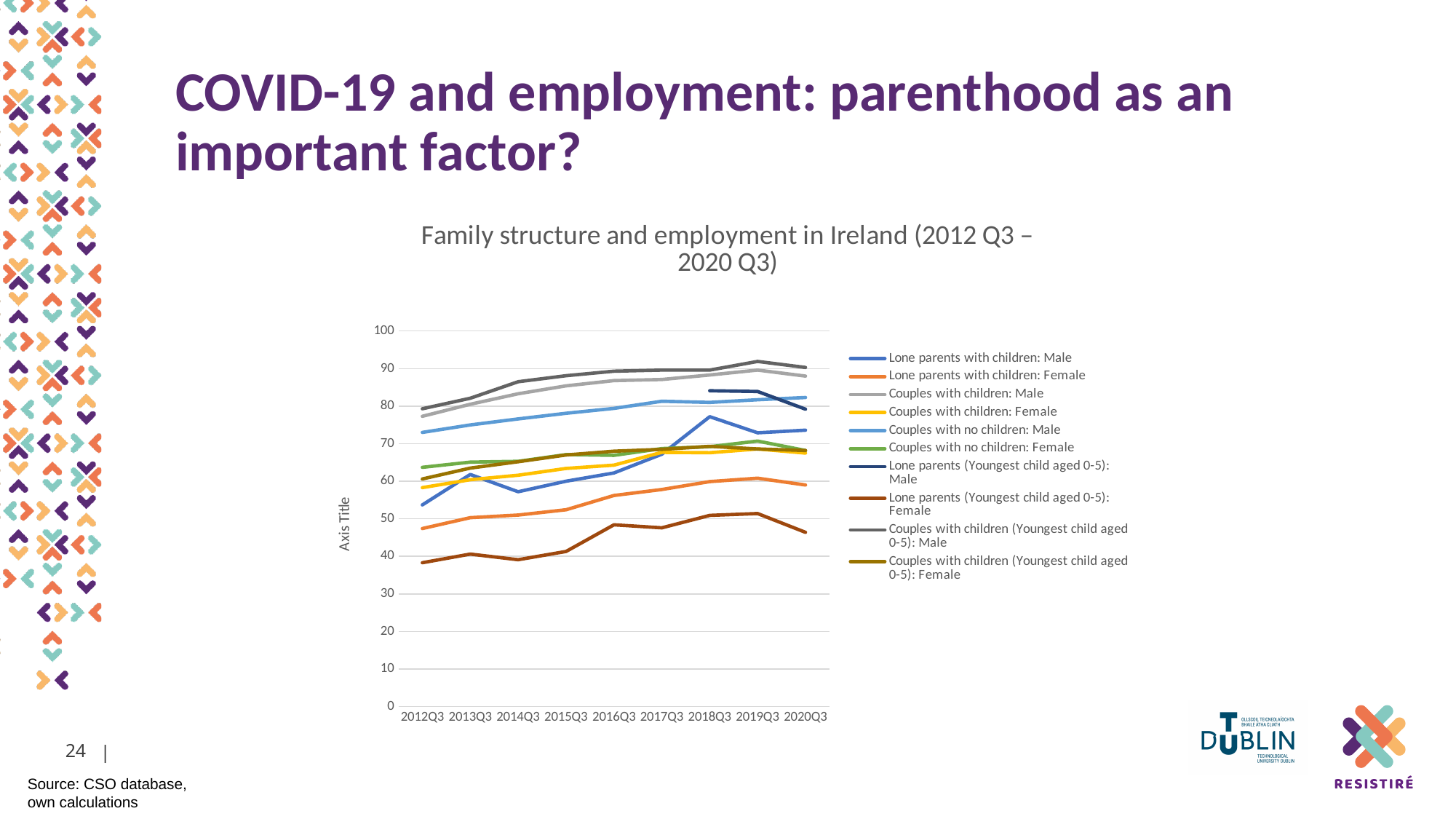
What is the label on the vertical axis of the chart? Axis Title Which series has the lowest value in 2020Q3? Lone parents (Youngest child aged 0-5): Female Does the Lone parents (Youngest child aged 0-5): Female series rise or fall between 2019Q3 and 2020Q3? Fall Is the value for Lone parents (Youngest child aged 0-5): Female in 2012Q3 greater or less than 50? less In 2020Q3, which is larger: Couples with children: Male or Couples with no children: Male? Couples with children: Male Is the value for Lone parents with children: Female in 2012Q3 greater or less than 50? less What kind of chart is shown on the slide? Line chart What is the title of the chart? Family structure and employment in Ireland (2012 Q3 – 2020 Q3) Which series has the highest value in 2019Q3? Couples with children (Youngest child aged 0-5): Male How many series does the legend of the chart list? 10 Is the value for Couples with no children: Male in 2020Q3 greater or less than 80? greater How many time points are shown along the x axis of the chart? 9